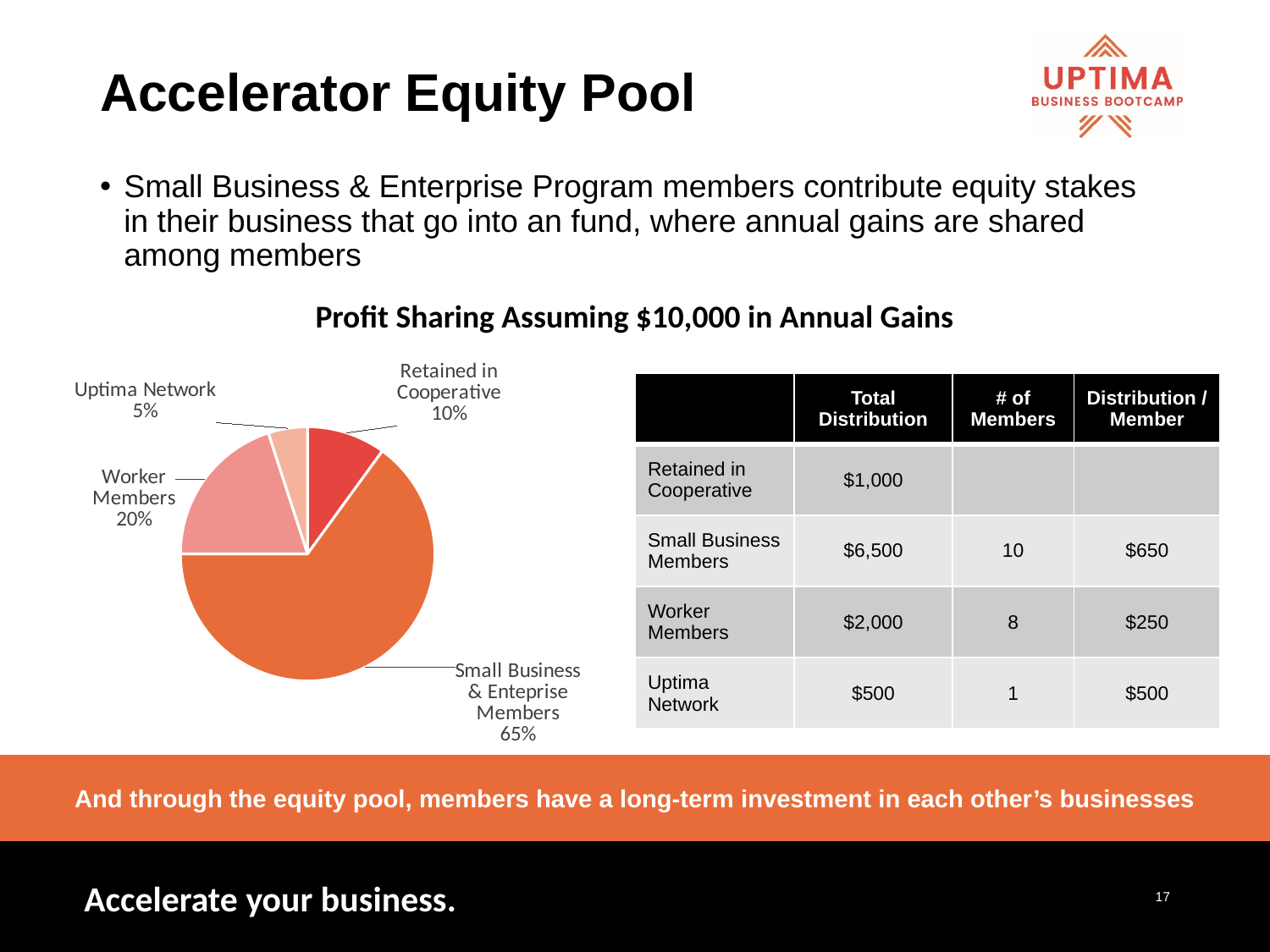
What share of the pie does Small Business & Enteprise Members hold? 65% What share of the pie does Retained in Cooperative hold? 10% How many slices does the pie chart have? 4 Which slice of the pie is the smallest? Uptima Network What share of the pie does Uptima Network hold? 5% What is the difference in percentage points between the Worker Members slice and the Retained in Cooperative slice? 10 What is the difference in percentage points between the Small Business & Enteprise Members slice and the Worker Members slice? 45 What kind of chart is shown on the slide? pie chart What is the title of the chart? Profit Sharing Assuming $10,000 in Annual Gains Which is larger, the Worker Members slice or the Uptima Network slice? Worker Members Which slice of the pie is the largest? Small Business & Enteprise Members